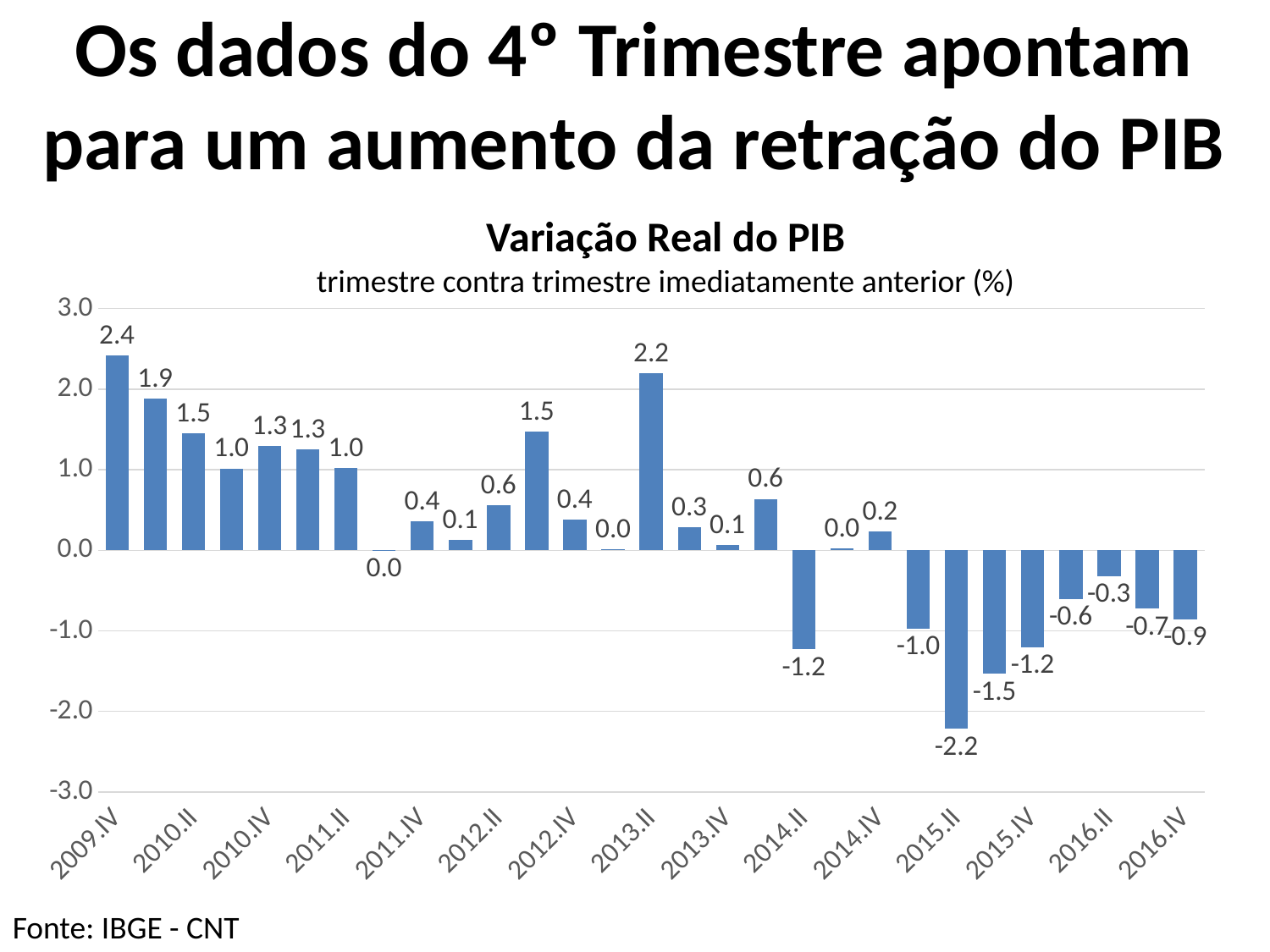
What is the title of the chart? Variação Real do PIB What is the difference between the values for 2009.IV and 2013.II? 0.2 What is the value for 2013.II? 2.2 What type of chart is shown on the slide? bar chart What is the value for 2009.IV? 2.4 How many bars are plotted in the chart? 29 Which is larger, the value for 2010.II or the value for 2012.II? 2010.II What is the value for 2014.II? -1.2 What is the value for 2015.II? -2.2 Which quarter has the highest value? 2009.IV What is the value for 2016.IV? -0.9 Which quarter has the lowest value? 2015.II